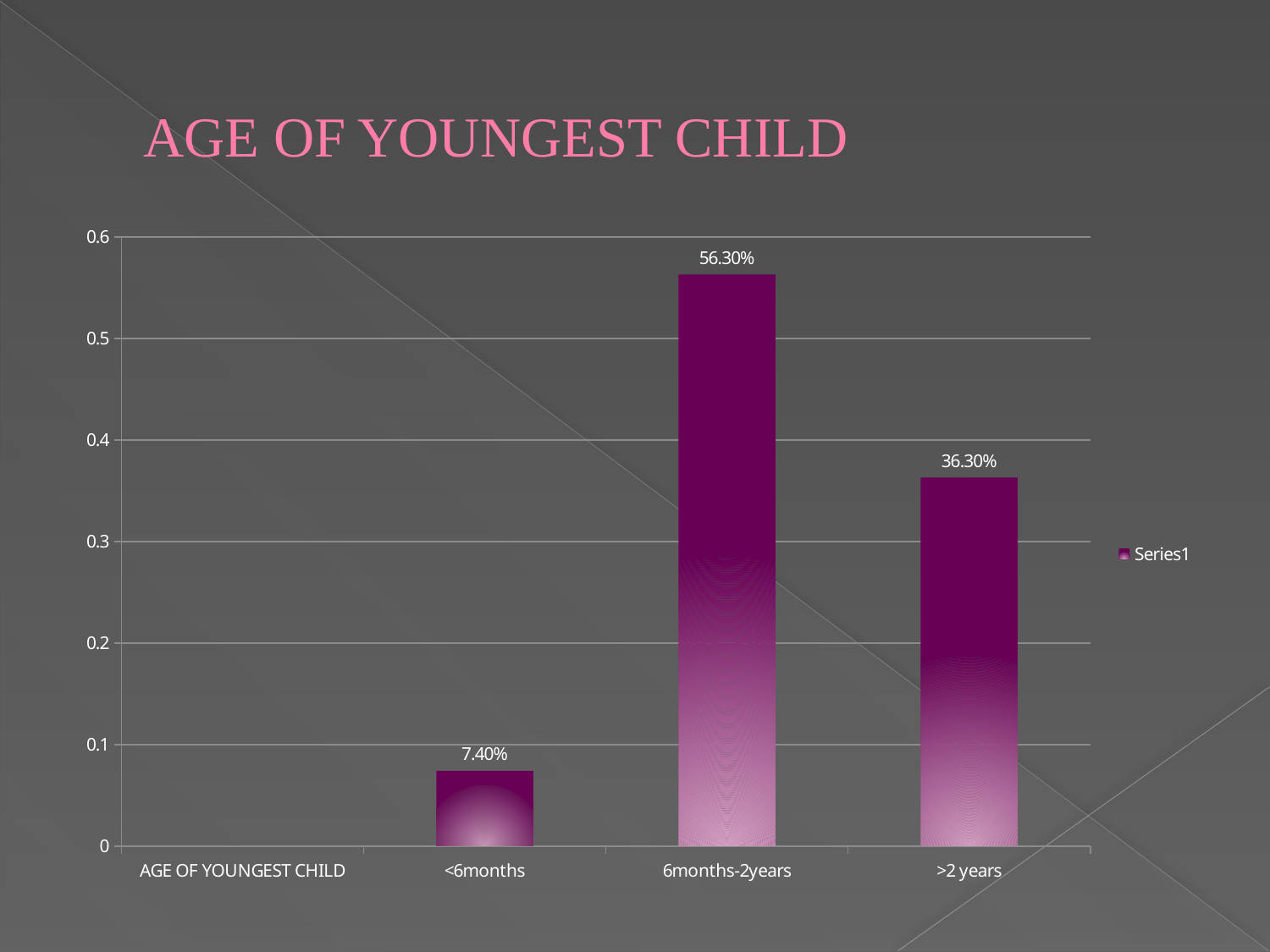
What is the difference between the values for >2 years and <6months? 28.90% How many bars are plotted on the chart? 3 What is the value for the >2 years category? 36.30% What is the value for the <6months category? 7.40% Which category has the lowest value among the plotted bars? <6months Is the value for 6months-2years greater or less than 0.5? greater What kind of chart is shown on the slide? bar chart What is the value for the 6months-2years category? 56.30% Which category has the highest value? 6months-2years What is the difference between the values for 6months-2years and >2 years? 20.00% What is the title of the slide? AGE OF YOUNGEST CHILD Which is larger, the value for >2 years or the value for <6months? >2 years